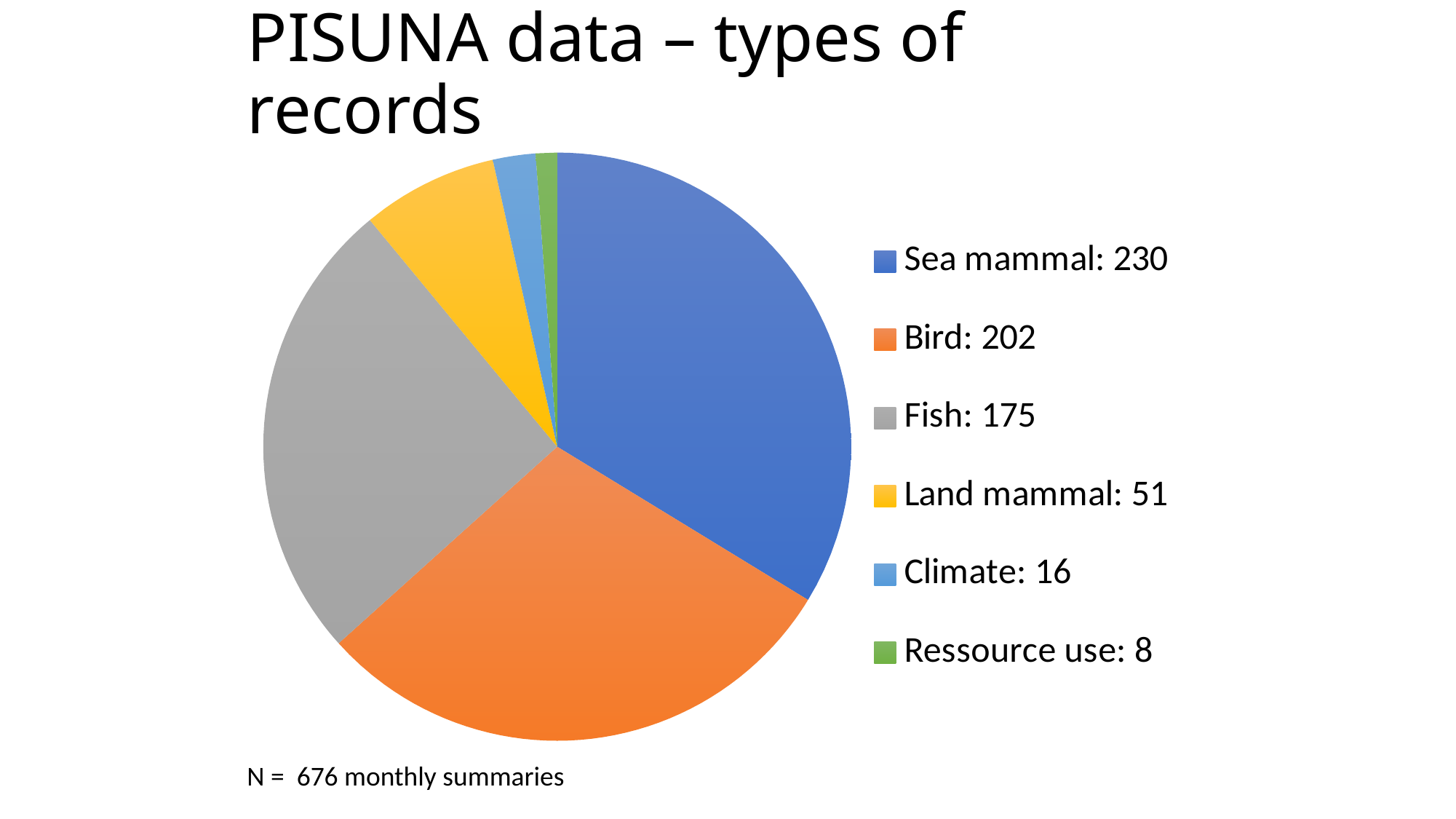
What is the title of the chart on the slide? PISUNA data – types of records How many records are there for Land mammal? 51 What is the difference between the number of Sea mammal records and Bird records? 28 Which record type has the most records? Sea mammal How many records are there for Climate? 16 Which record type has the fewest records? Ressource use What type of chart is shown on the slide? Pie chart How many records are there for Bird? 202 How many records are there for Fish? 175 Which has more records, Fish or Land mammal? Fish How many records are there for Sea mammal? 230 How many record types does the legend list? 6